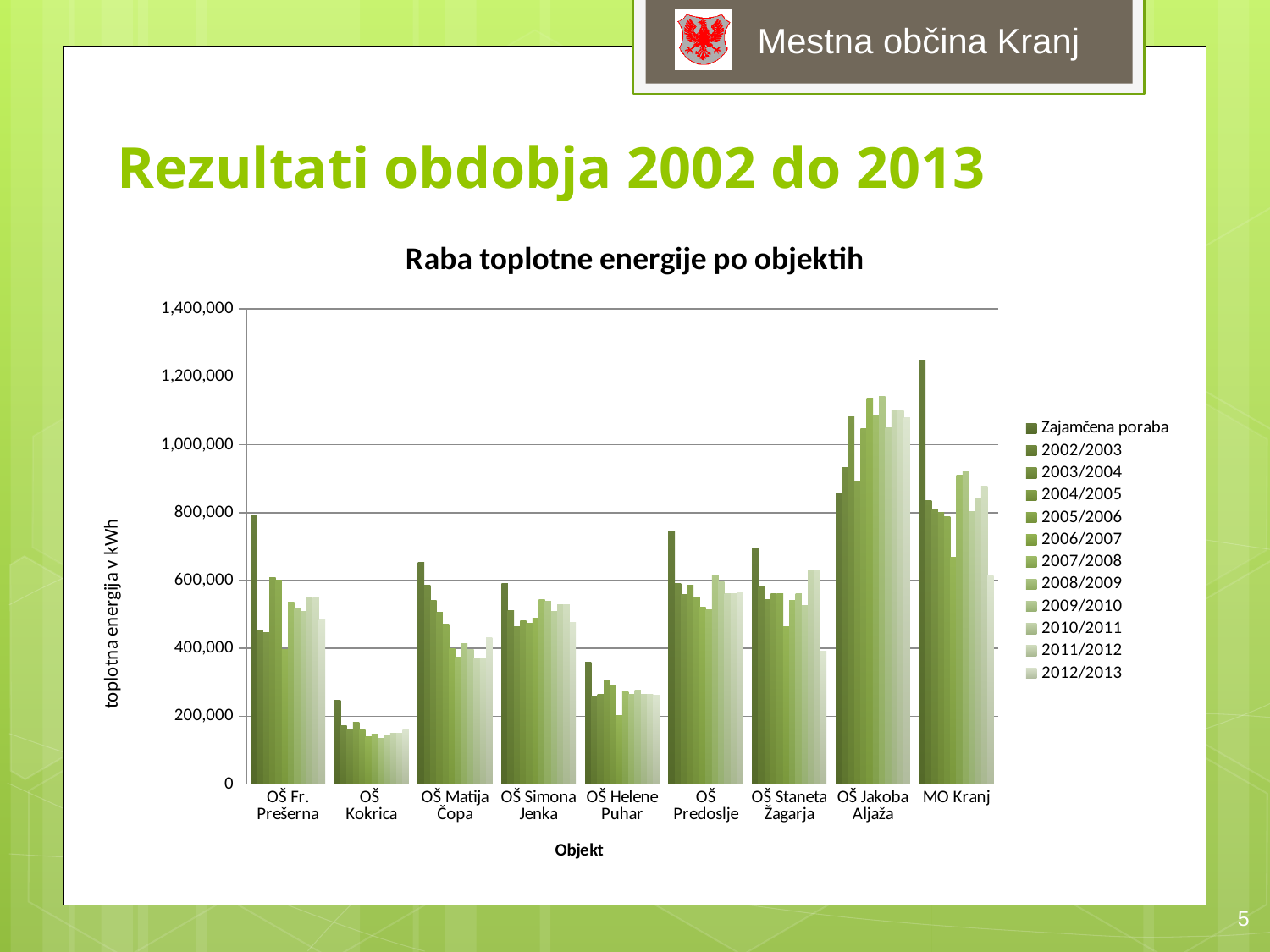
Is the Zajamčena poraba value for OŠ Kokrica greater or less than 200,000? greater Is the Zajamčena poraba value for MO Kranj greater or less than 1,200,000? greater Is the Zajamčena poraba value for OŠ Helene Puhar greater or less than 400,000? less What is the label of the y axis of the chart? toplotna energija v kWh What kind of chart is shown on the slide? bar chart What is the title of the chart? Raba toplotne energije po objektih Which object has the lowest bars overall in the chart? OŠ Kokrica How many objects (categories) are shown on the x axis of the chart? 9 Which object has the highest bars overall in the chart? OŠ Jakoba Aljaža How many series does the chart legend list? 12 Which has the larger Zajamčena poraba value, OŠ Jakoba Aljaža or MO Kranj? MO Kranj